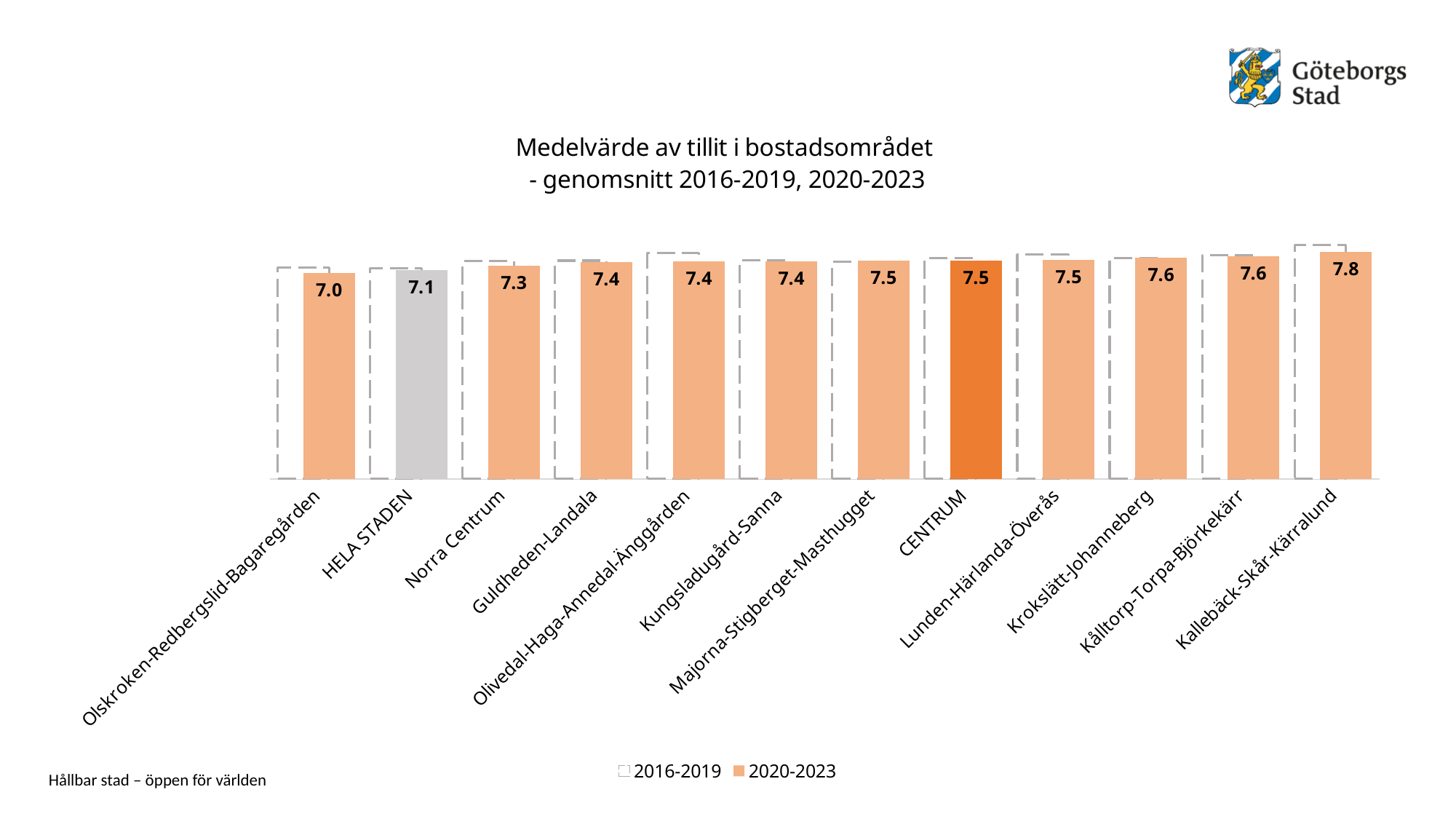
How many categories are shown on the x axis? 12 What is the 2020-2023 value for Norra Centrum? 7.3 Which has the larger 2020-2023 value, Krokslätt-Johanneberg or HELA STADEN? Krokslätt-Johanneberg What is the 2020-2023 value for CENTRUM? 7.5 What kind of chart is shown on the slide? Bar chart What is the 2020-2023 value for Kallebäck-Skår-Kärralund? 7.8 What is the difference between the 2020-2023 values for Kallebäck-Skår-Kärralund and Olskroken-Redbergslid-Bagaregården? 0.8 Which category has the lowest 2020-2023 value? Olskroken-Redbergslid-Bagaregården How many series does the legend list? 2 What is the 2020-2023 value for Olskroken-Redbergslid-Bagaregården? 7.0 Which area has the highest 2020-2023 value? Kallebäck-Skår-Kärralund What is the 2020-2023 value for HELA STADEN? 7.1